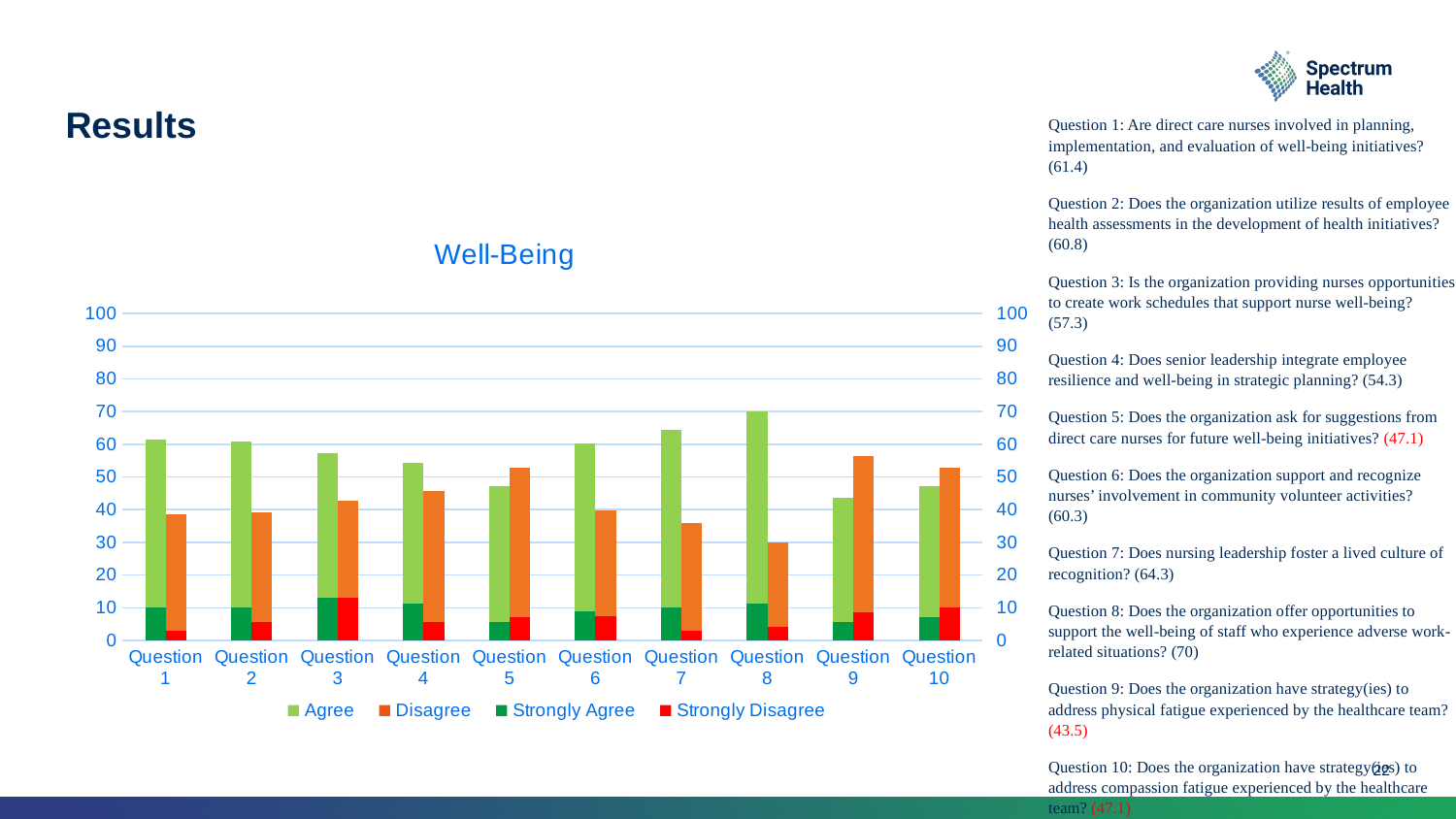
How many series does the chart's legend list? 4 Which question has the highest Agree value? Question 8 Is the Disagree value for Question 9 greater or less than 50? greater What is the Agree value for Question 8? 70 Is the Agree value for Question 5 greater or less than 50? less Which question has the lowest Agree value? Question 9 For Question 9, which is larger: Agree or Disagree? Disagree Is the Disagree value for Question 8 greater or less than 40? less What is the title of the chart? Well-Being What kind of chart is shown on the slide? bar chart For Question 3, which is larger: Agree or Disagree? Agree How many questions (categories) are shown on the x axis of the chart? 10